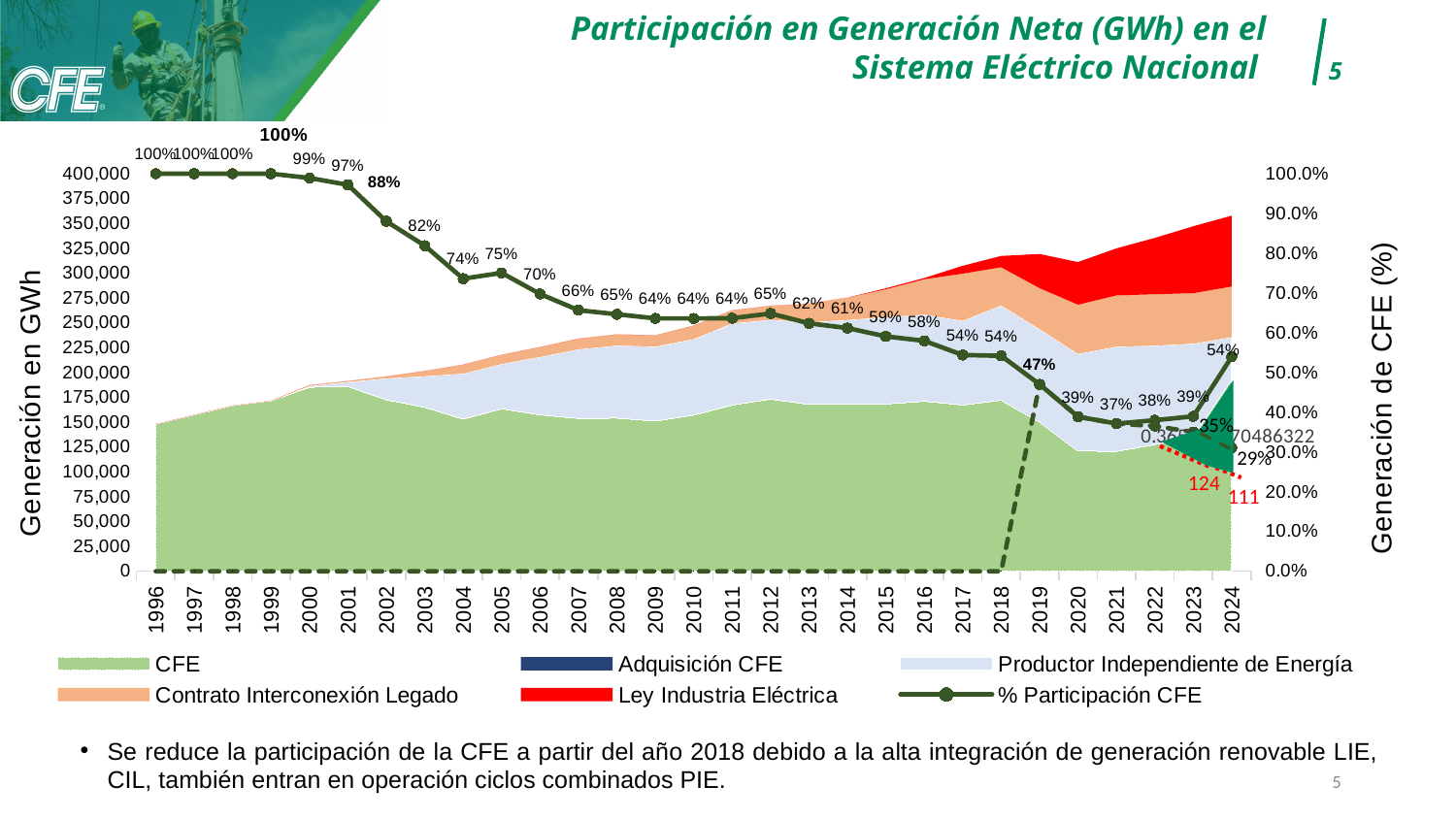
What is the title of the left vertical axis? Generación en GWh By how many percentage points does % Participación CFE drop from 2018 to 2019? 7 percentage points What is the % Participación CFE value for 2002? 88% In which year is the labeled % Participación CFE lowest? 2021 Which year has the higher % Participación CFE, 2004 or 2005? 2005 What is the % Participación CFE value for 2019? 47% Does the % Participación CFE line generally rise or fall from 1996 to 2023? Fall How many series does the legend list? 6 Is the CFE generation (green area) in 2020 greater or less than 150,000 GWh? less How many years are shown on the x axis? 29 What is the % Participación CFE value for 2021? 37% What is the % Participación CFE value for 2006? 70%